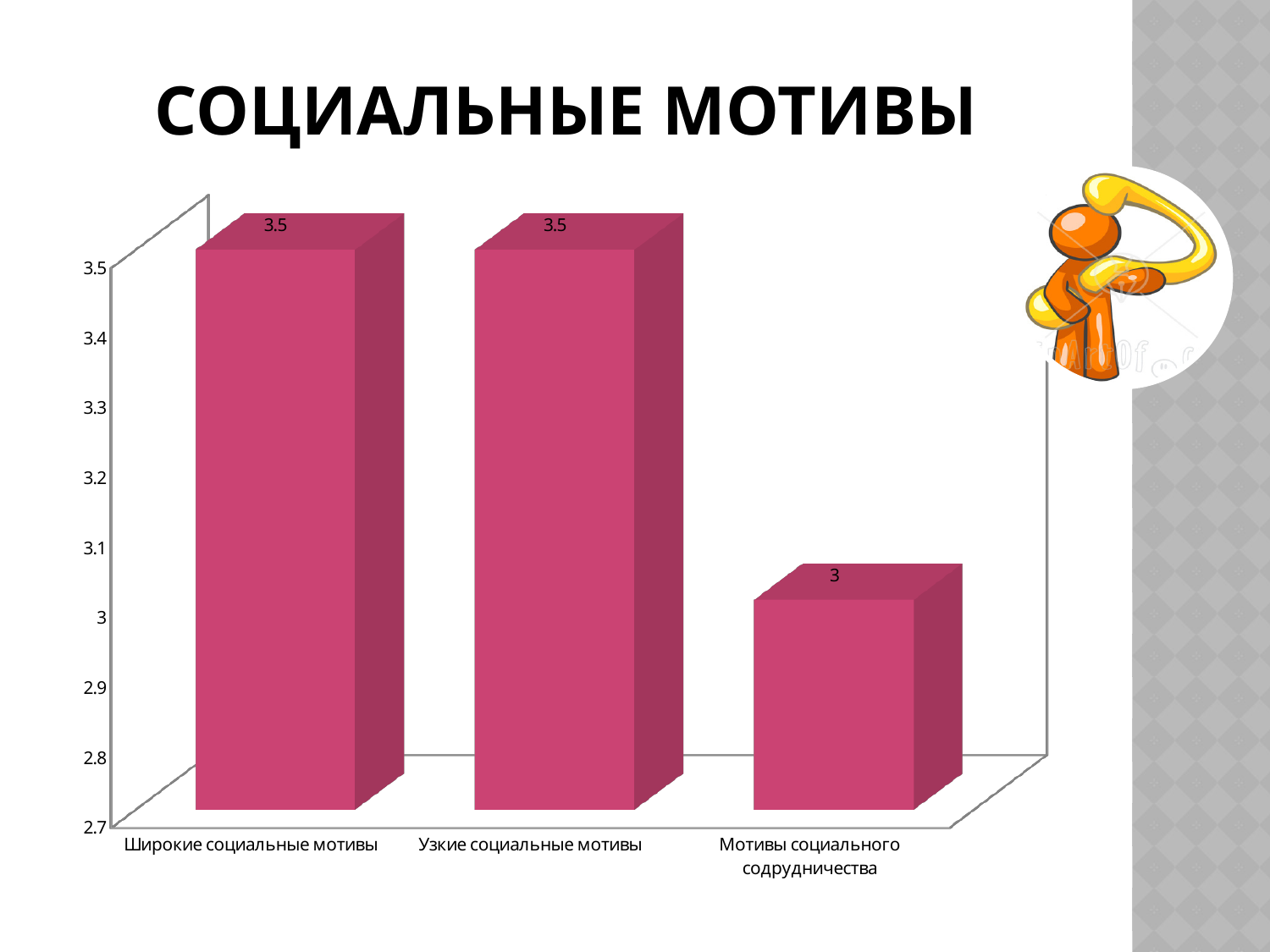
What is the value for Широкие социальные мотивы? 3.5 What is the difference between the values for Широкие социальные мотивы and Мотивы социального содружничества? 0.5 Do the values rise or fall from the first category to the last? fall What is the lowest value shown on the vertical axis? 2.7 Which is larger, the value for Узкие социальные мотивы or the value for Мотивы социального содружничества? Узкие социальные мотивы What kind of chart is shown on the slide? bar chart Is the value for Мотивы социального содружничества greater or less than 3.2? less How many categories are shown on the chart? 3 Which category has the lowest value? Мотивы социального содрудничества What is the title of the slide? СОЦИАЛЬНЫЕ МОТИВЫ What is the value for Узкие социальные мотивы? 3.5 What is the value for Мотивы социального содружничества? 3